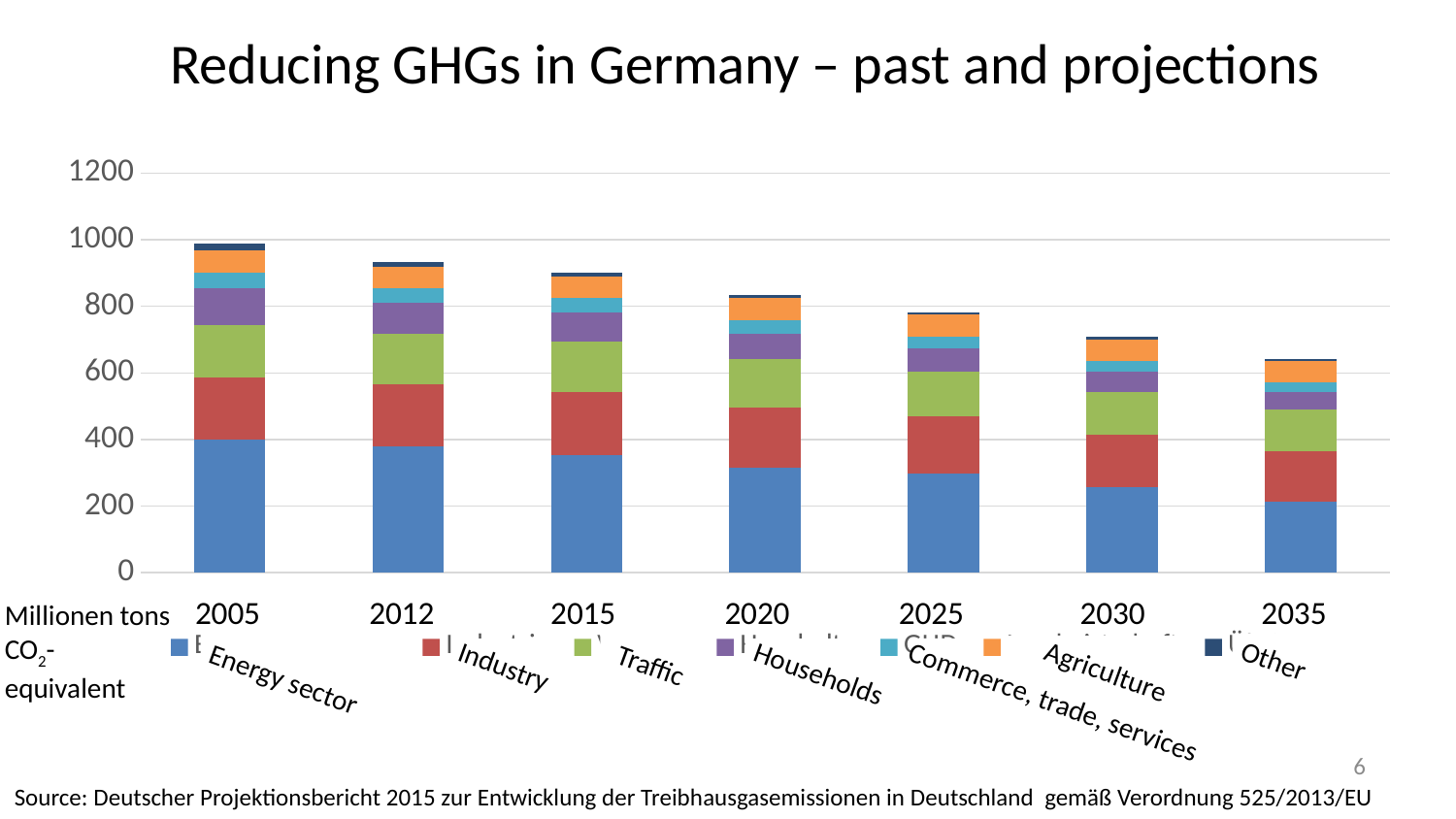
What is the title of the chart? Reducing GHGs in Germany – past and projections Is the Energy sector segment for 2035 greater or less than 400? less Which is larger, the total bar for 2005 or the total bar for 2035? 2005 Which series forms the largest segment of the 2005 bar? Energy sector Is the total bar for 2005 greater or less than 800? greater Which year has the lowest total emissions bar? 2035 Is the total bar for 2030 greater or less than 800? less What kind of chart is shown on the slide? Stacked bar chart How many series does the chart's legend list? 7 How many years are shown on the x axis of the chart? 7 Which year has the highest total emissions bar? 2005 Do the total emissions rise or fall from 2005 to 2035? Fall